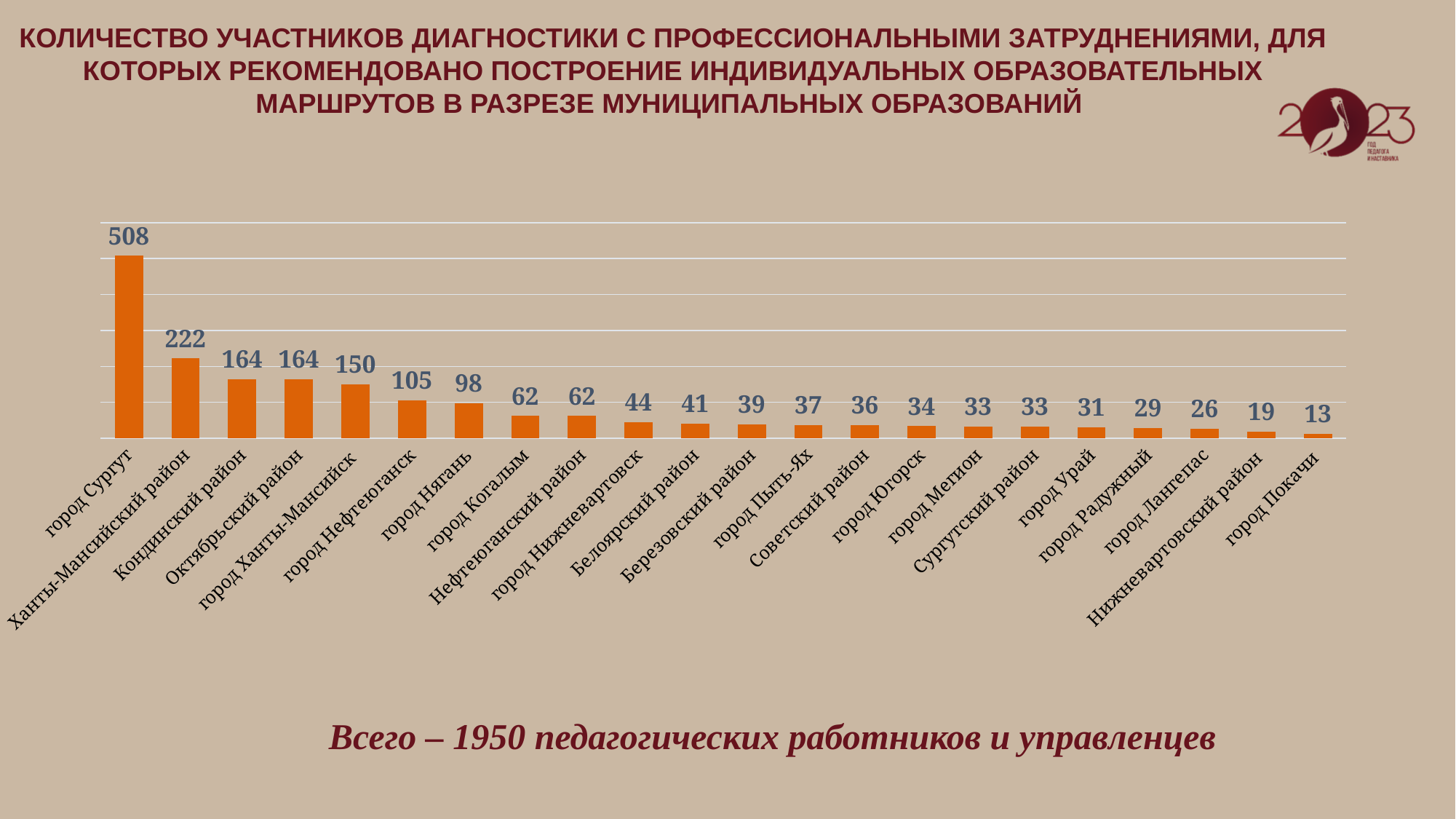
What kind of chart is shown on the slide? bar chart Which category has the highest value? город Сургут What is the value for город Лангепас? 26 What is the value for город Нефтеюганск? 105 What is the value for Ханты-Мансийский район? 222 Which is larger, the value for город Нижневартовск or the value for город Урай? город Нижневартовск How many categories are shown in the chart? 22 Which category has the lowest value? город Покачи What is the value for город Сургут? 508 What is the difference between the values for город Сургут and Ханты-Мансийский район? 286 Do the values rise or fall from left to right along the x axis? fall What is the difference between the values for город Ханты-Мансийск and город Нягань? 52